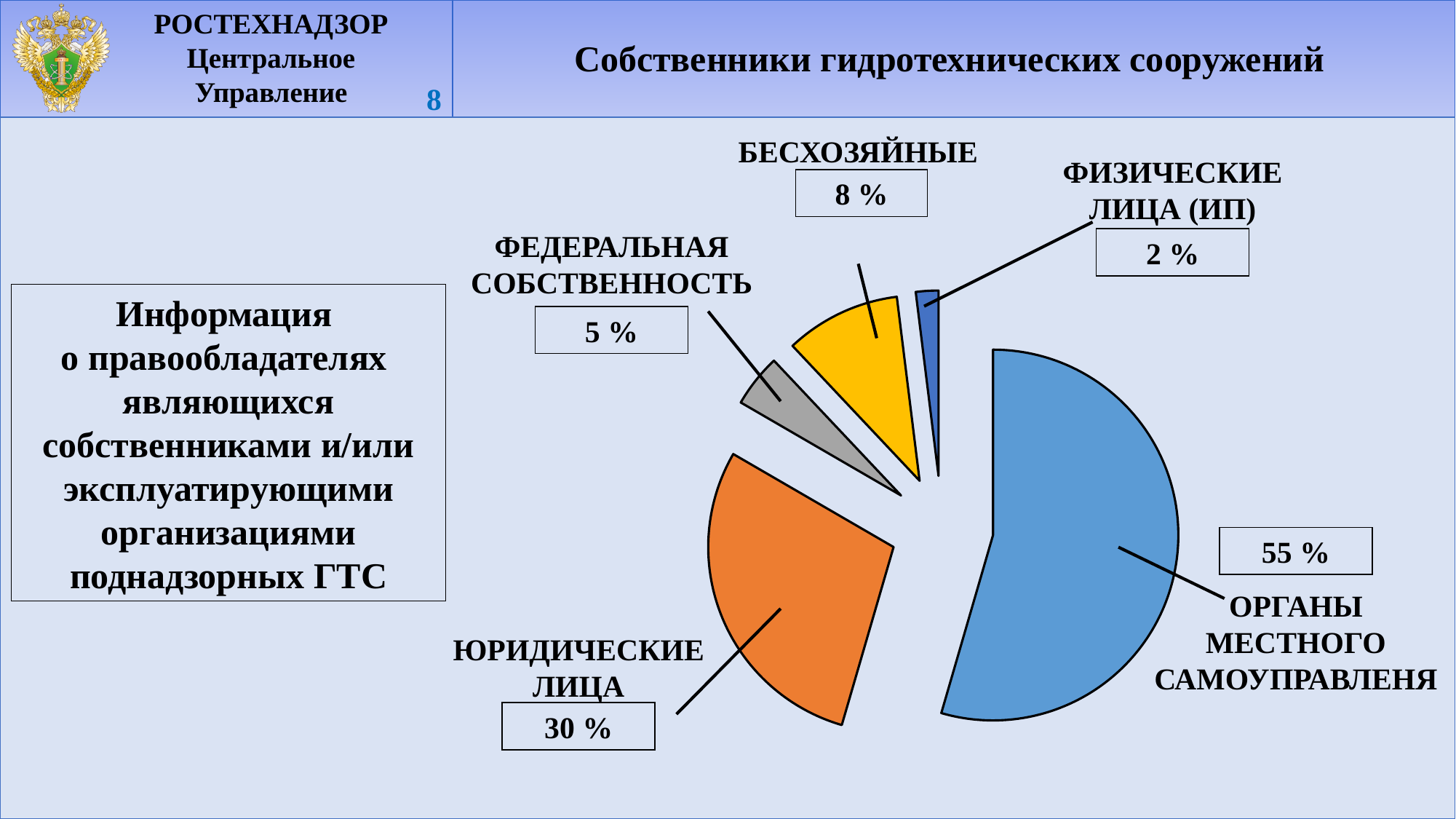
What share of the pie chart is labelled ФИЗИЧЕСКИЕ ЛИЦА (ИП)? 2 % What share of the pie chart is labelled ОРГАНЫ МЕСТНОГО САМОУПРАВЛЕНЯ? 55 % How many slices does the pie chart have? 5 What share of the pie chart is labelled ЮРИДИЧЕСКИЕ ЛИЦА? 30 % What is the difference in percentage points between ОРГАНЫ МЕСТНОГО САМОУПРАВЛЕНЯ and ЮРИДИЧЕСКИЕ ЛИЦА? 25 % What share of the pie chart is labelled ФЕДЕРАЛЬНАЯ СОБСТВЕННОСТЬ? 5 % Which category has the largest slice of the pie chart? ОРГАНЫ МЕСТНОГО САМОУПРАВЛЕНЯ What kind of chart is shown on the slide? pie chart Which is larger, the share for БЕСХОЗЯЙНЫЕ or the share for ФЕДЕРАЛЬНАЯ СОБСТВЕННОСТЬ? БЕСХОЗЯЙНЫЕ Which category has the smallest slice of the pie chart? ФИЗИЧЕСКИЕ ЛИЦА (ИП) What share of the pie chart is labelled БЕСХОЗЯЙНЫЕ? 8 % What is the title of the chart on the slide? Собственники гидротехнических сооружений